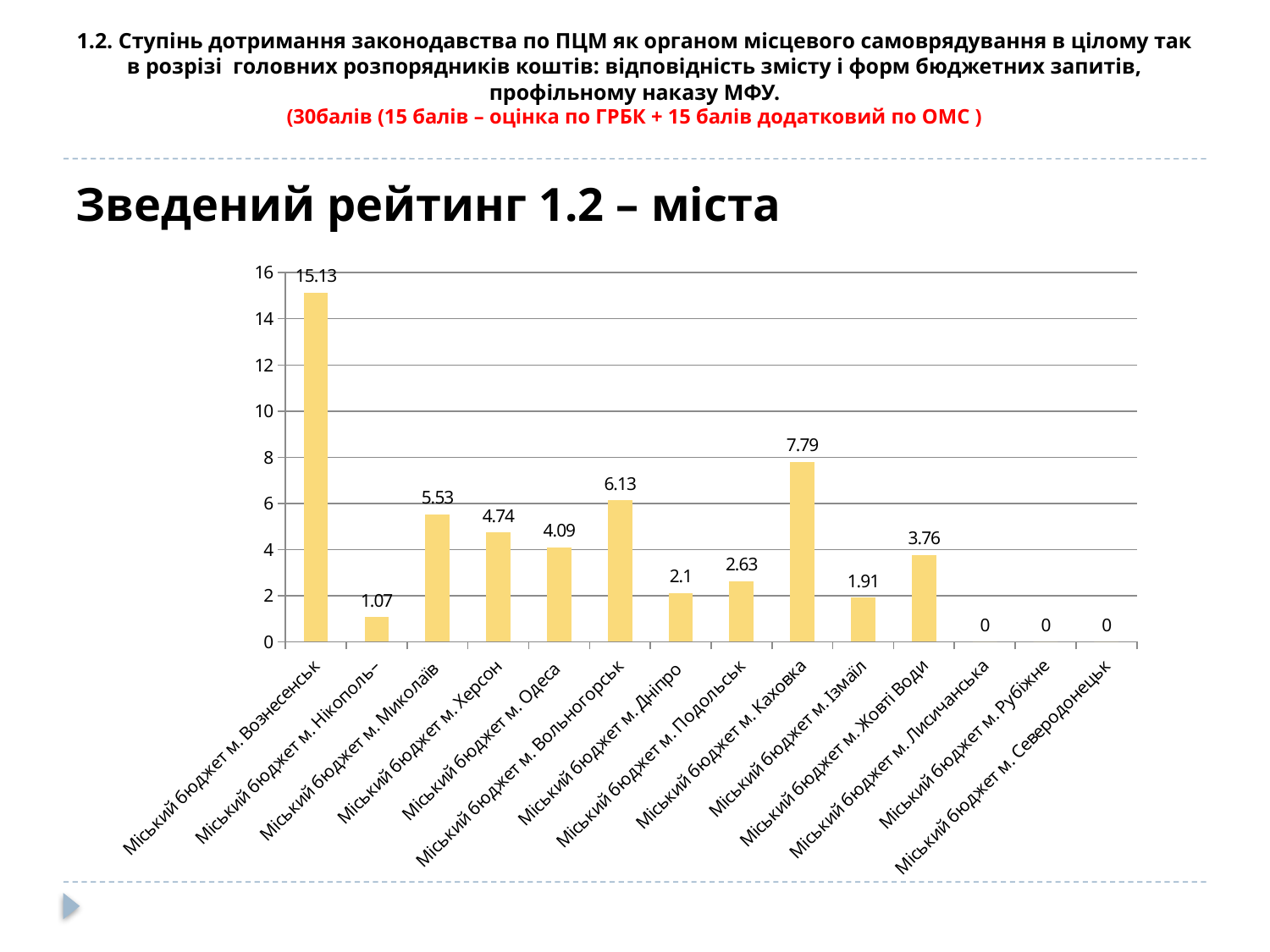
Which is larger, the value for Міський бюджет м. Вольногорськ or the value for Міський бюджет м. Одеса? Міський бюджет м. Вольногорськ Which category has the highest value? Міський бюджет м. Вознесенськ What is the value for Міський бюджет м. Каховка? 7.79 What is the title of the chart? Зведений рейтинг 1.2 – міста What is the difference between the values for Міський бюджет м. Миколаїв and Міський бюджет м. Херсон? 0.79 What is the value for Міський бюджет м. Нікополь? 1.07 What is the value for Міський бюджет м. Жовті Води? 3.76 How many categories are shown on the x axis? 14 Is the value for Міський бюджет м. Каховка greater or less than 6? greater What kind of chart is shown on the slide? bar chart What is the value for Міський бюджет м. Вознесенськ? 15.13 How many categories have a value of 0? 3